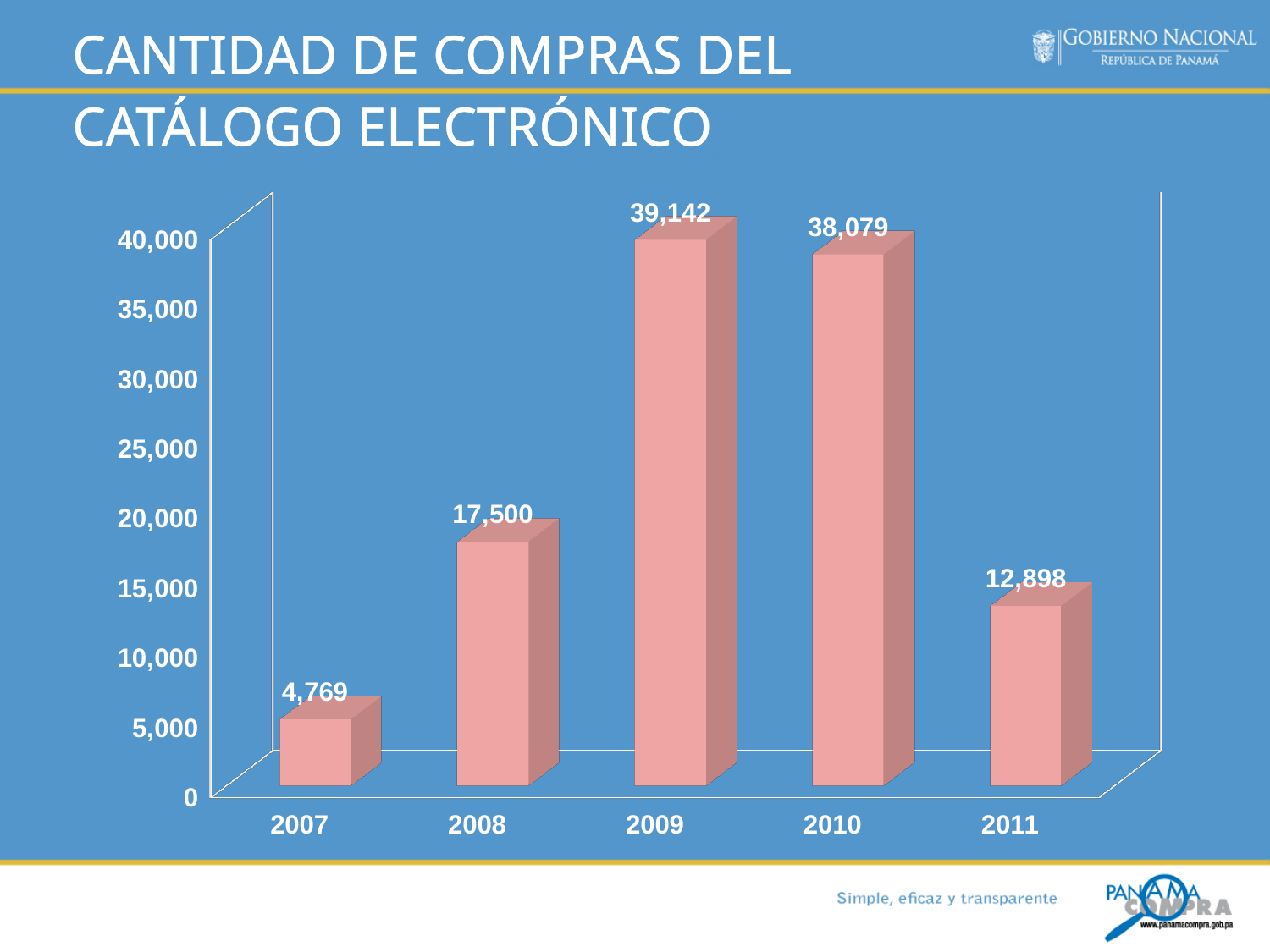
What is the value for 2007? 4,769 What is the value for 2011? 12,898 Which is larger, the value for 2008 or the value for 2011? 2008 How many years are shown on the x axis? 5 Which year has the lowest value? 2007 What kind of chart is shown on the slide? bar chart Is the value for 2010 greater or less than 35,000? greater Do the values rise or fall from 2010 to 2011? fall What is the difference between the values for 2008 and 2007? 12,731 What is the value for 2009? 39,142 What is the difference between the values for 2009 and 2010? 1,063 Which year has the highest value? 2009